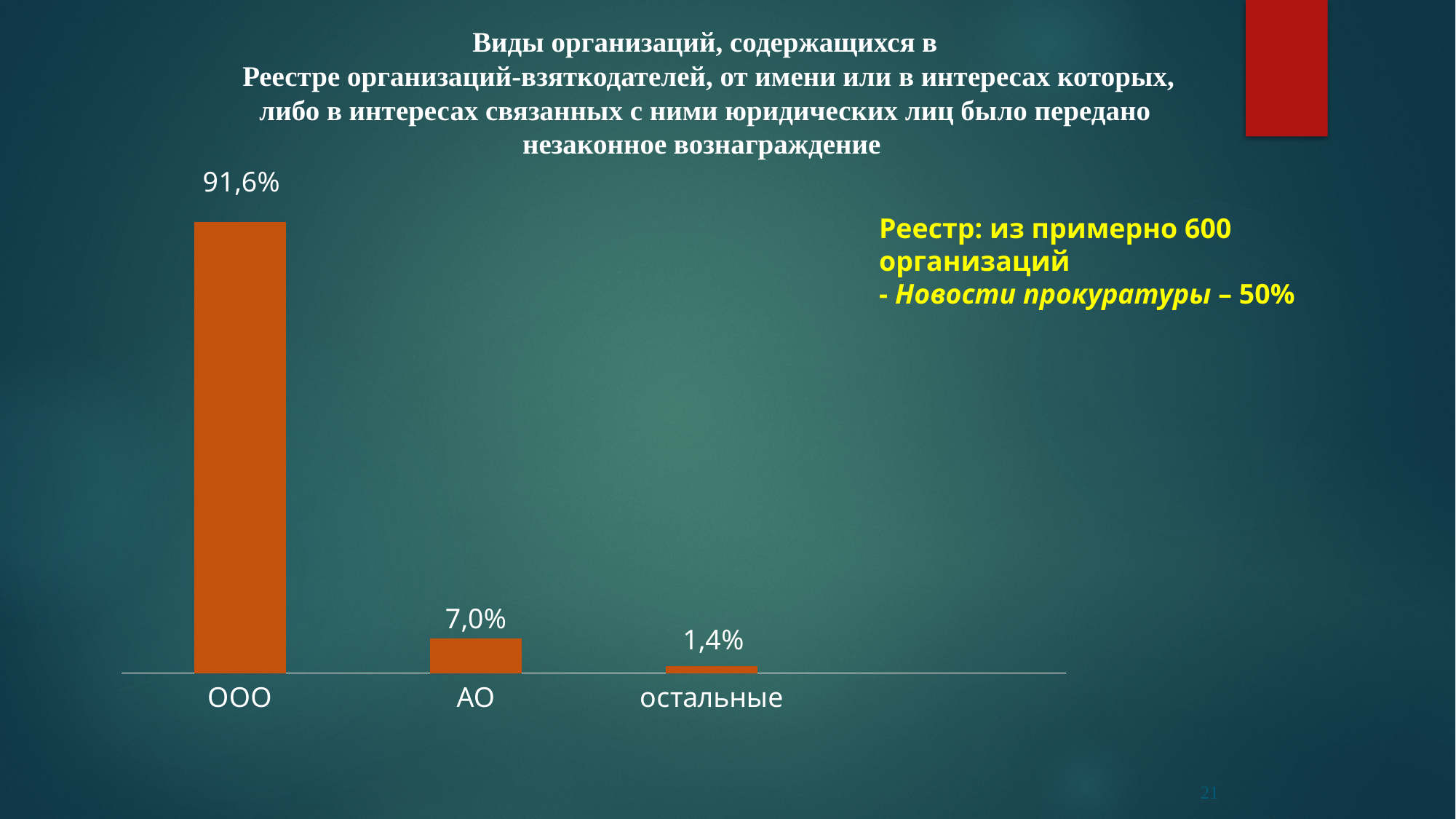
Do the values rise or fall from left to right along the x axis? fall What is the value for остальные? 1,4% Which is larger, the value for АО or the value for остальные? АО What colour are the bars in the chart? orange What is the value for ООО? 91,6% What is the difference between the values for ООО and АО? 84,6% Which category has the highest value? ООО How many categories are shown in the chart? 3 What is the value for АО? 7,0% What kind of chart is shown on the slide? bar chart Which category has the lowest value? остальные What is the difference between the values for АО and остальные? 5,6%